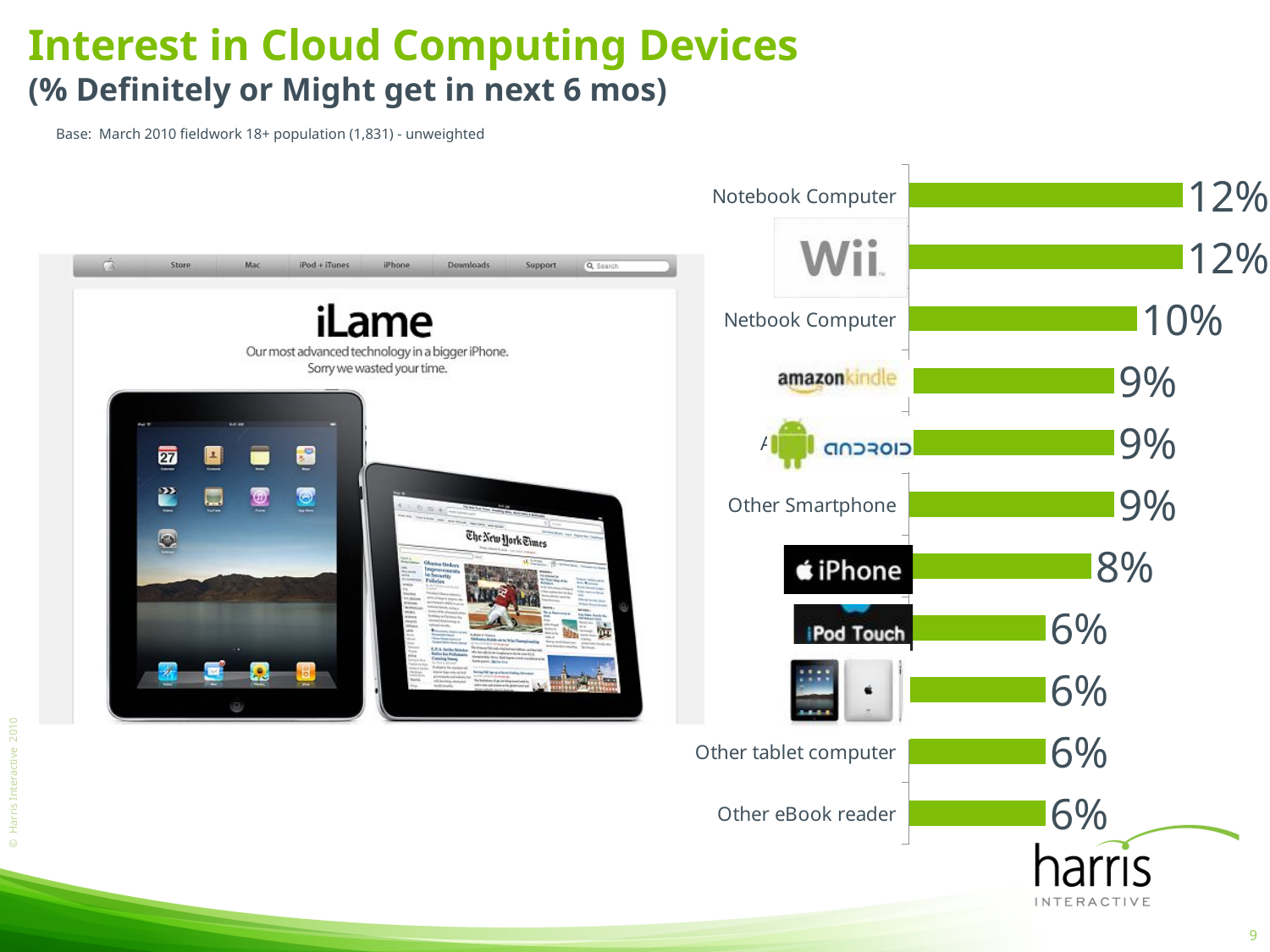
What is the value for iPhone? 8% What is the value for Other eBook reader? 6% Which has a larger value, Netbook Computer or iPhone? Netbook Computer What is the value for Other Smartphone? 9% What kind of chart is shown on the slide? Bar chart What is the value for Netbook Computer? 10% How many bars are shown on the chart? 11 What is the value for Notebook Computer? 12% What is the value for Other tablet computer? 6% What is the difference between the values for Netbook Computer and Other Smartphone? 1 percentage point What is the difference between the values for Notebook Computer and Other eBook reader? 6 percentage points What is the highest value shown on the chart? 12%